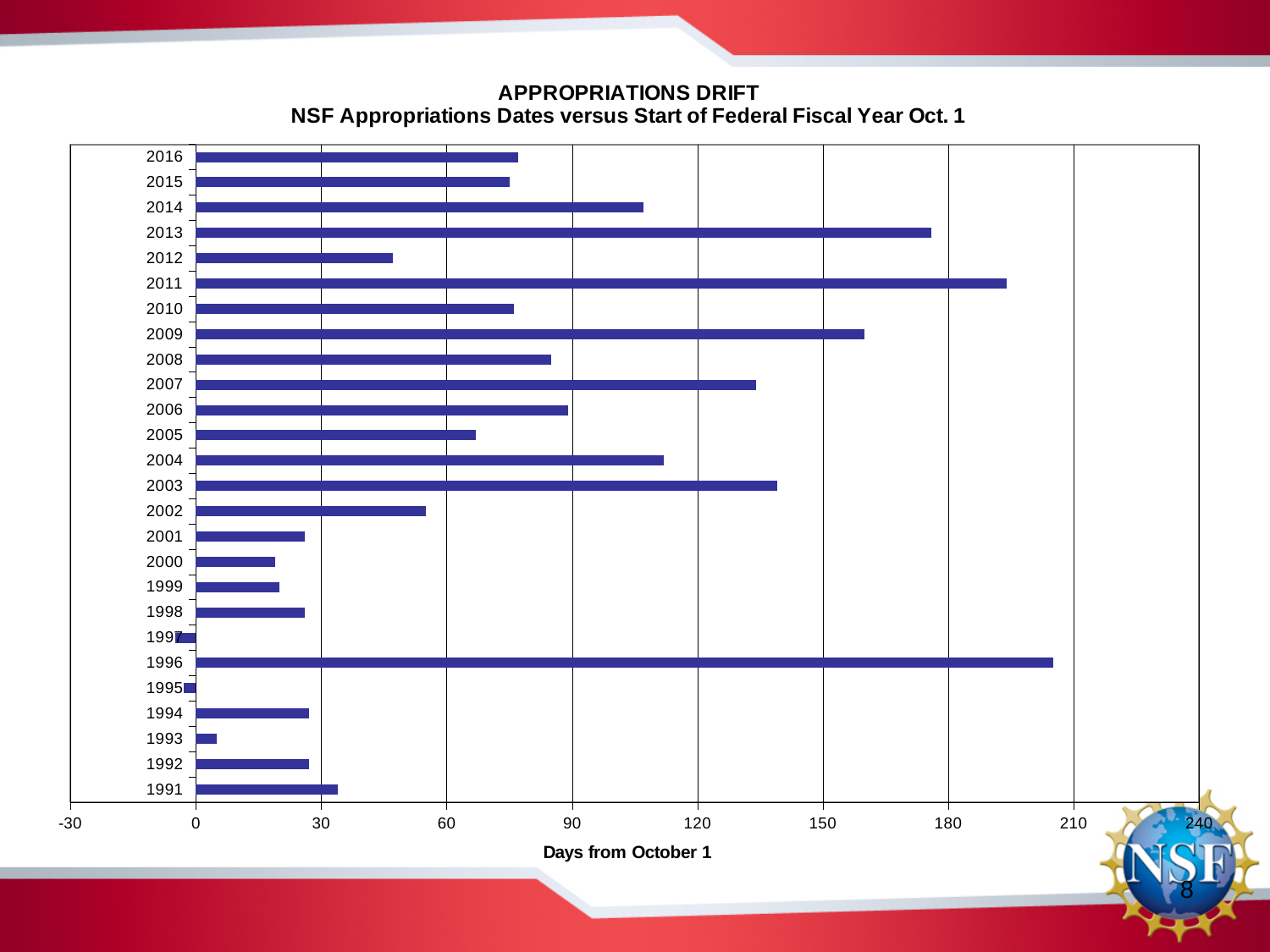
Is the value for 1993 greater or less than 30? less Which has the larger value, 2011 or 2009? 2011 Which year has the highest value on the chart? 1996 Is the value for 2011 greater or less than 180? greater What is the title of the horizontal axis? Days from October 1 Is the value for 2012 greater or less than 60? less What kind of chart is shown on the slide? bar chart Which has the larger value, 2013 or 2014? 2013 What is the first line of the chart title? APPROPRIATIONS DRIFT How many years are plotted on the chart? 26